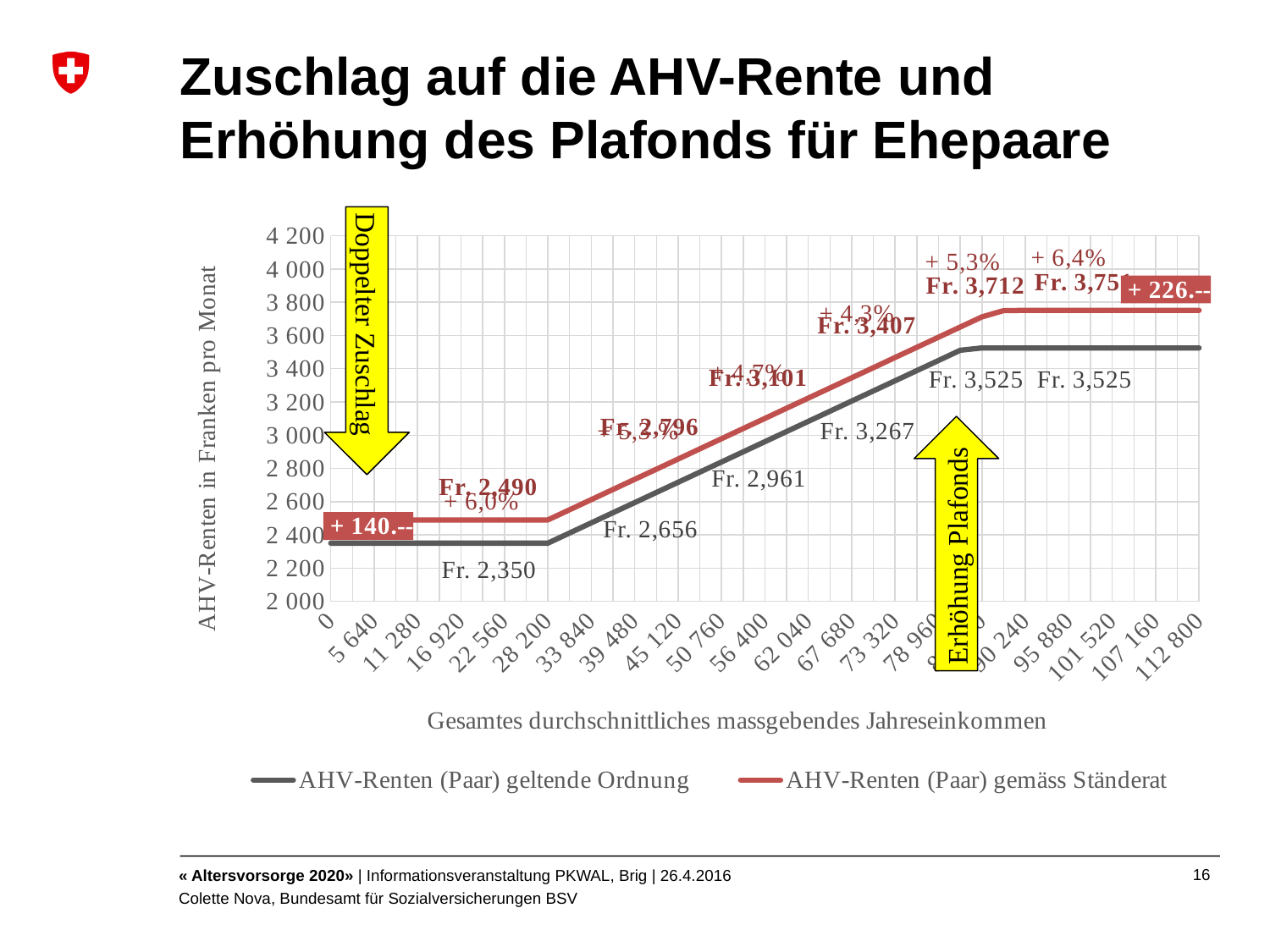
How many series does the legend list? 2 What is the highest labelled value of the 'AHV-Renten (Paar) geltende Ordnung' series? Fr. 3,525 What is the lowest labelled value of the 'AHV-Renten (Paar) gemäss Ständerat' series? Fr. 2,490 What is the difference between the starting values Fr. 2,490 (gemäss Ständerat) and Fr. 2,350 (geltende Ordnung)? 140 Which series lies higher on the chart, 'geltende Ordnung' or 'gemäss Ständerat'? AHV-Renten (Paar) gemäss Ständerat What amount is shown in the red box at the right end of the chart, at the plafond? + 226.-- What is the title of the x axis? Gesamtes durchschnittliches massgebendes Jahreseinkommen Do the values of the 'geltende Ordnung' series rise or fall as income increases from 0 to about 84 600? rise What is the lowest labelled value of the 'AHV-Renten (Paar) geltende Ordnung' series? Fr. 2,350 How many labelled data points does the 'geltende Ordnung' series have? 6 What kind of chart is shown on the slide? line chart What percentage increase is printed next to the Fr. 2,490 label? + 6,0%